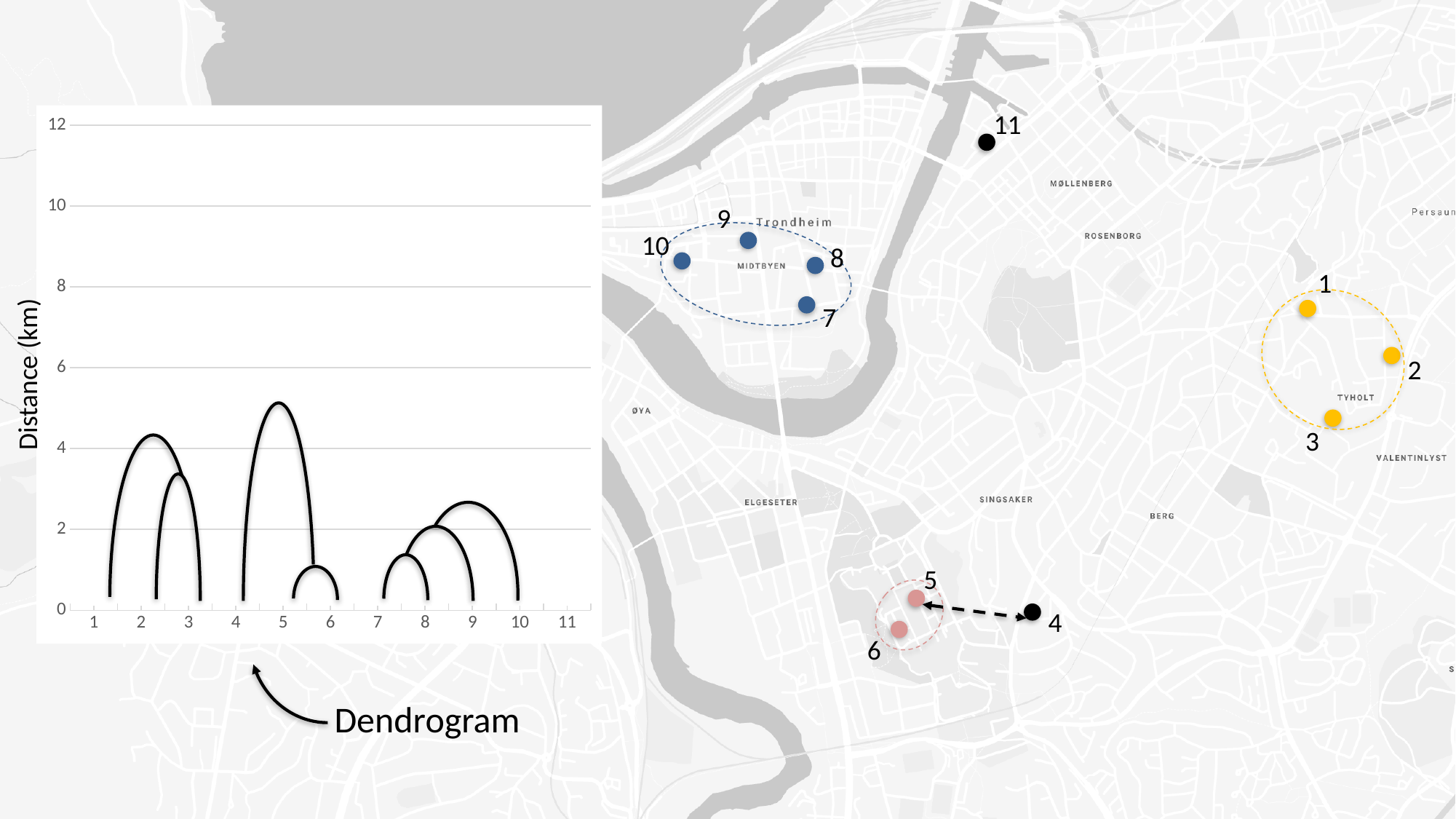
What kind of chart is shown on the slide? Dendrogram How many leaves (numbered points) does the dendrogram join? 10 Is the merge distance of the arc joining points 5 and 6 greater or less than 2? less Is the merge distance of the arc joining point 4 with points 5 and 6 greater or less than 4? greater What is the highest value shown on the y axis of the dendrogram? 12 Is the merge distance of the arc joining points 7 and 8 greater or less than 2? less What is the label of the y axis of the dendrogram? Distance (km) Which merge in the dendrogram occurs at the greatest distance? Point 4 joining points 5 and 6 How many merge arcs does the dendrogram contain? 7 Which merge happens at a greater distance: point 4 joining points 5 and 6, or point 1 joining points 2 and 3? Point 4 joining points 5 and 6